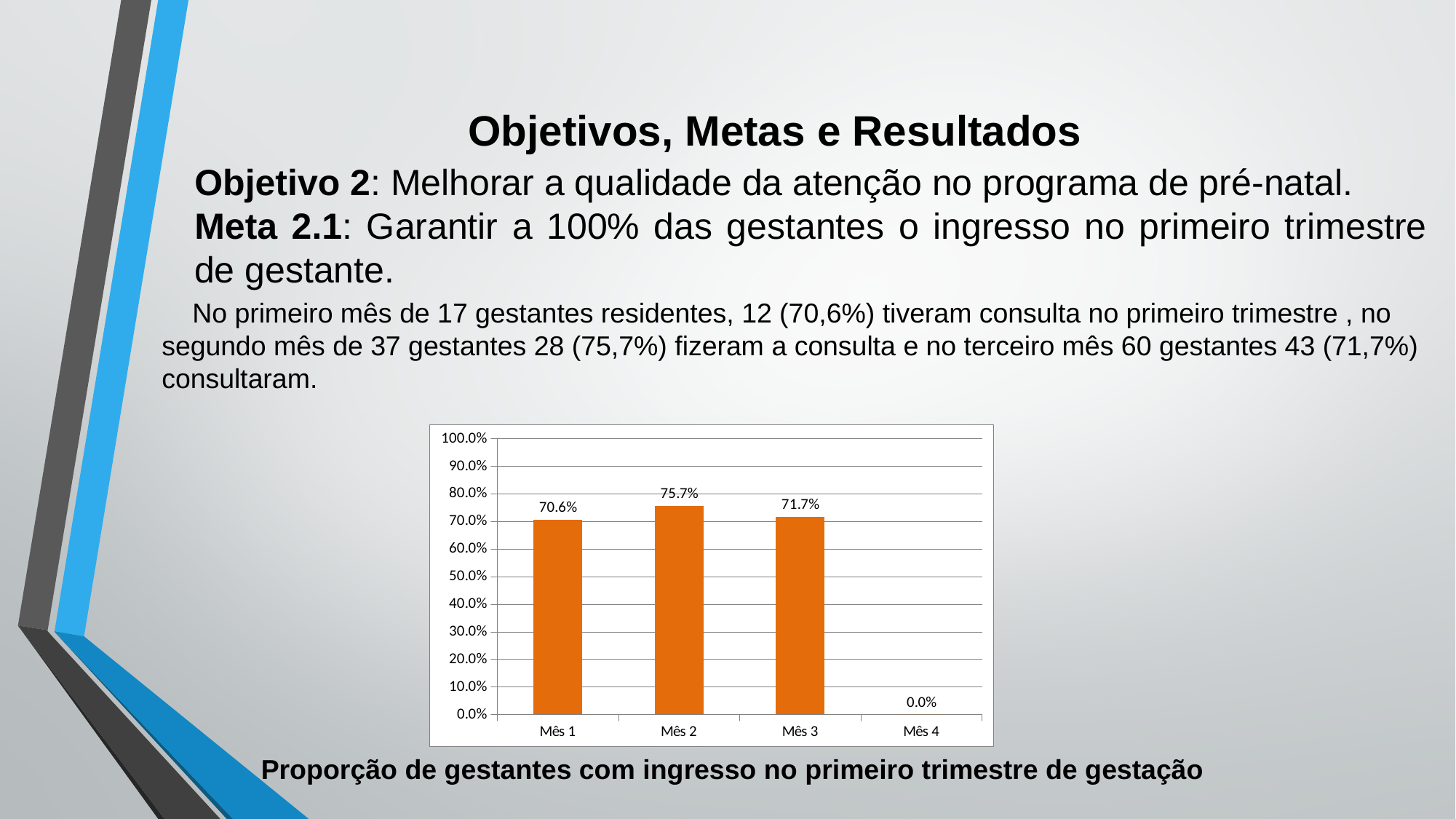
Which month has the lowest value? Mês 4 Which month has the highest value? Mês 2 What is the value for Mês 2? 75.7% Which is larger, the value for Mês 2 or the value for Mês 3? Mês 2 What is the difference between the values for Mês 2 and Mês 1? 5.1% What is the value for Mês 1? 70.6% What kind of chart is shown on the slide? bar chart What is the caption below the chart? Proporção de gestantes com ingresso no primeiro trimestre de gestação What is the value for Mês 3? 71.7% How many categories are shown on the x axis? 4 What is the value for Mês 4? 0.0% Is the value for Mês 3 greater or less than 80%? less